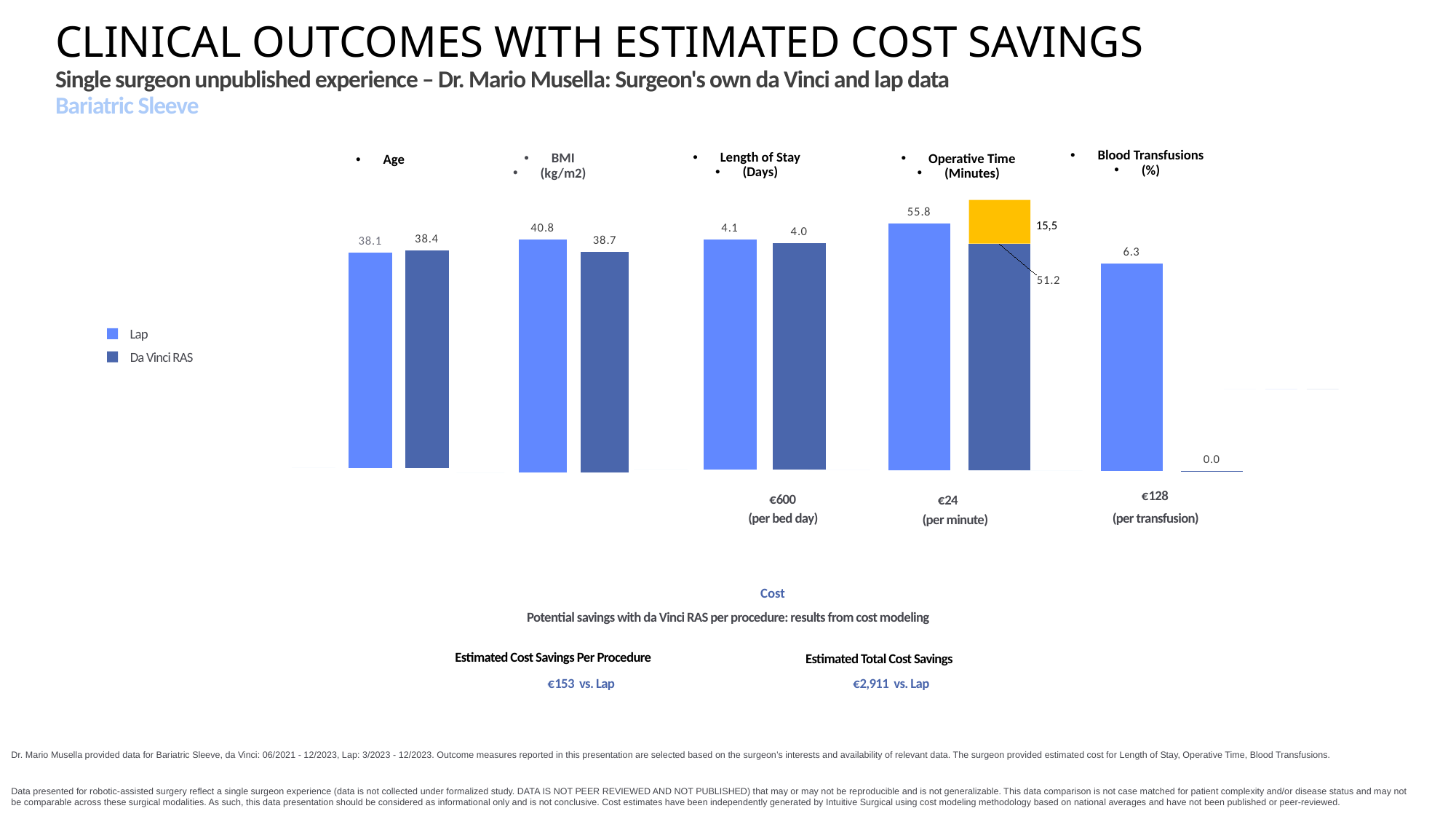
In the Age chart, what is the value for Da Vinci RAS? 38.4 In the BMI (kg/m2) chart, what is the value for Lap? 40.8 In the Blood Transfusions (%) chart, what is the value for Da Vinci RAS? 0.0 In the Operative Time (Minutes) chart, what is the value for Lap? 55.8 In the Blood Transfusions (%) chart, what is the value for Lap? 6.3 How many series does the legend list? 2 In the Length of Stay (Days) chart, what is the value for Da Vinci RAS? 4.0 In the Age chart, what is the value for Lap? 38.1 What kind of chart is used for the Age comparison? Bar chart In the BMI (kg/m2) chart, what is the difference between the Lap and Da Vinci RAS values? 2.1 In the Operative Time (Minutes) chart, which is larger, Lap or Da Vinci RAS? Lap In the Operative Time (Minutes) chart, what is the value for Da Vinci RAS? 51.2